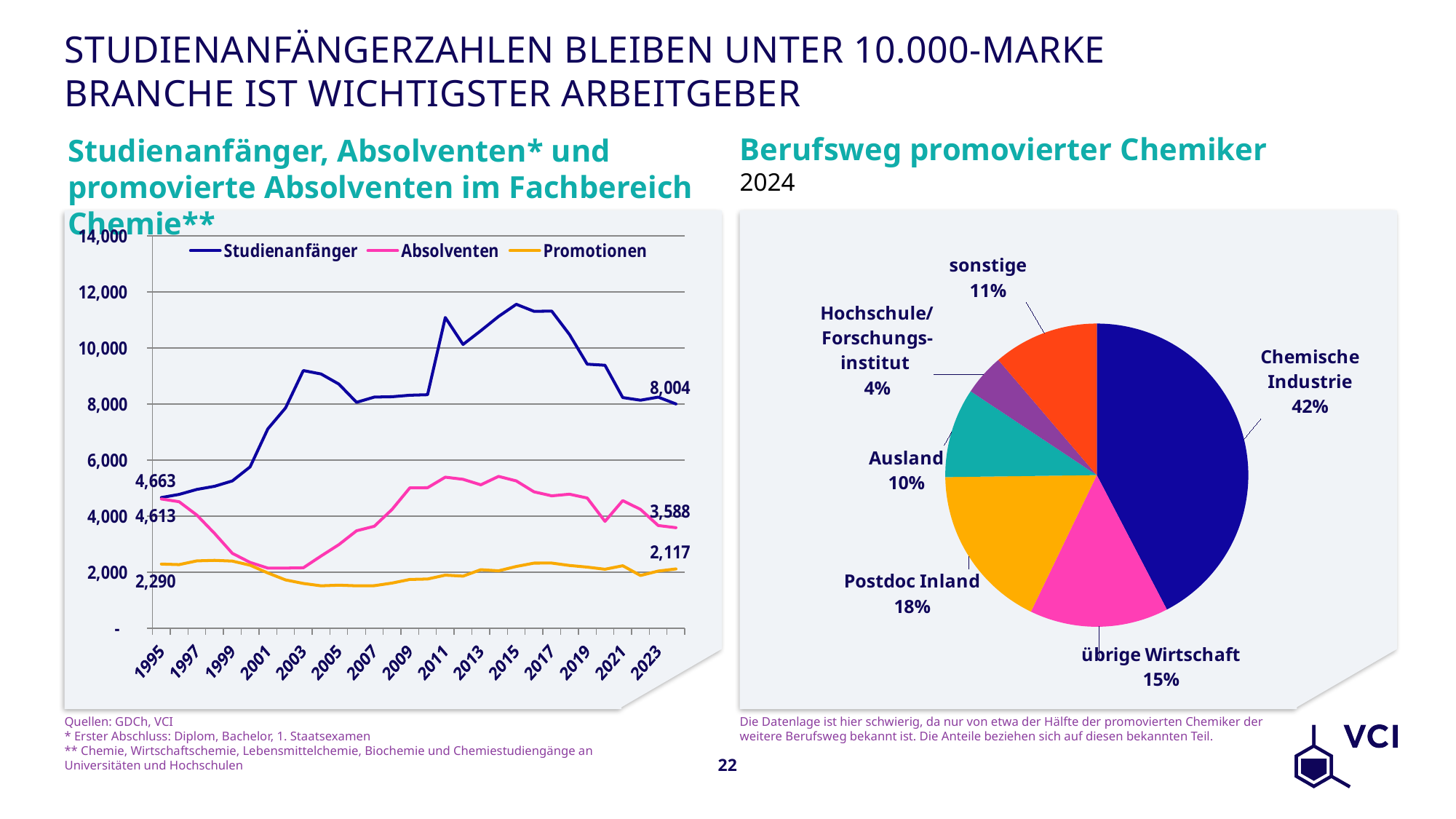
In the pie chart 'Berufsweg promovierter Chemiker', how many percentage points larger is Postdoc Inland than übrige Wirtschaft? 3 percentage points In the left line chart, what is the labelled value for Absolventen in 1995? 4,613 In the left line chart, is the value for Studienanfänger in 2015 greater or less than 10,000? greater In the left line chart, what is the difference between the most recent labelled Studienanfänger value (8,004) and the 1995 value (4,663)? 3,341 In the pie chart 'Berufsweg promovierter Chemiker', which category has the largest share? Chemische Industrie How many slices does the pie chart 'Berufsweg promovierter Chemiker' have? 6 In the pie chart 'Berufsweg promovierter Chemiker', which is larger: Ausland or sonstige? sonstige In the left line chart, what is the most recent labelled value for Studienanfänger? 8,004 In the pie chart 'Berufsweg promovierter Chemiker', what share goes to Chemische Industrie? 42% In the pie chart 'Berufsweg promovierter Chemiker', which category has the smallest share? Hochschule/Forschungsinstitut How many series does the legend of the left line chart list? 3 What kind of chart is the left chart 'Studienanfänger, Absolventen* und promovierte Absolventen im Fachbereich Chemie**'? Line chart